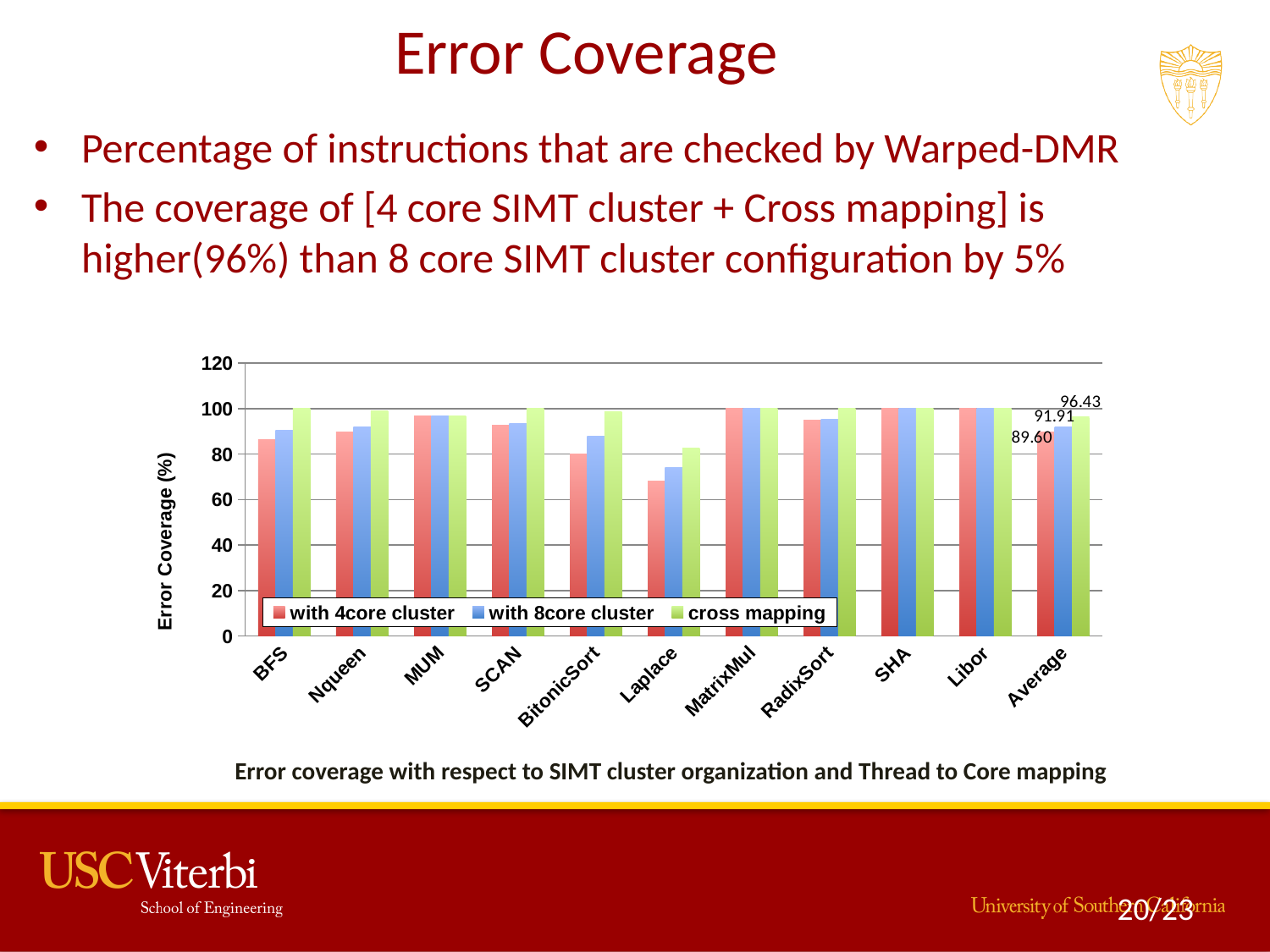
For the Average category, what is the difference between the 'cross mapping' value and the 'with 8core cluster' value? 4.52 Which is larger: the 'cross mapping' value for BitonicSort or the 'cross mapping' value for Laplace? BitonicSort What is the value for Average in the 'with 8core cluster' series? 91.91 What is the title of the chart's y axis? Error Coverage (%) What is the value for Average in the 'with 4core cluster' series? 89.60 How many categories are shown on the x axis of the chart? 11 What kind of chart is shown on the slide? bar chart How many series does the chart's legend list? 3 Is the 'with 4core cluster' value for Laplace greater or less than 80? less Which category has the lowest value in the 'with 4core cluster' series? Laplace For the Average category, what is the difference between the 'cross mapping' value and the 'with 4core cluster' value? 6.83 What is the value for Average in the 'cross mapping' series? 96.43